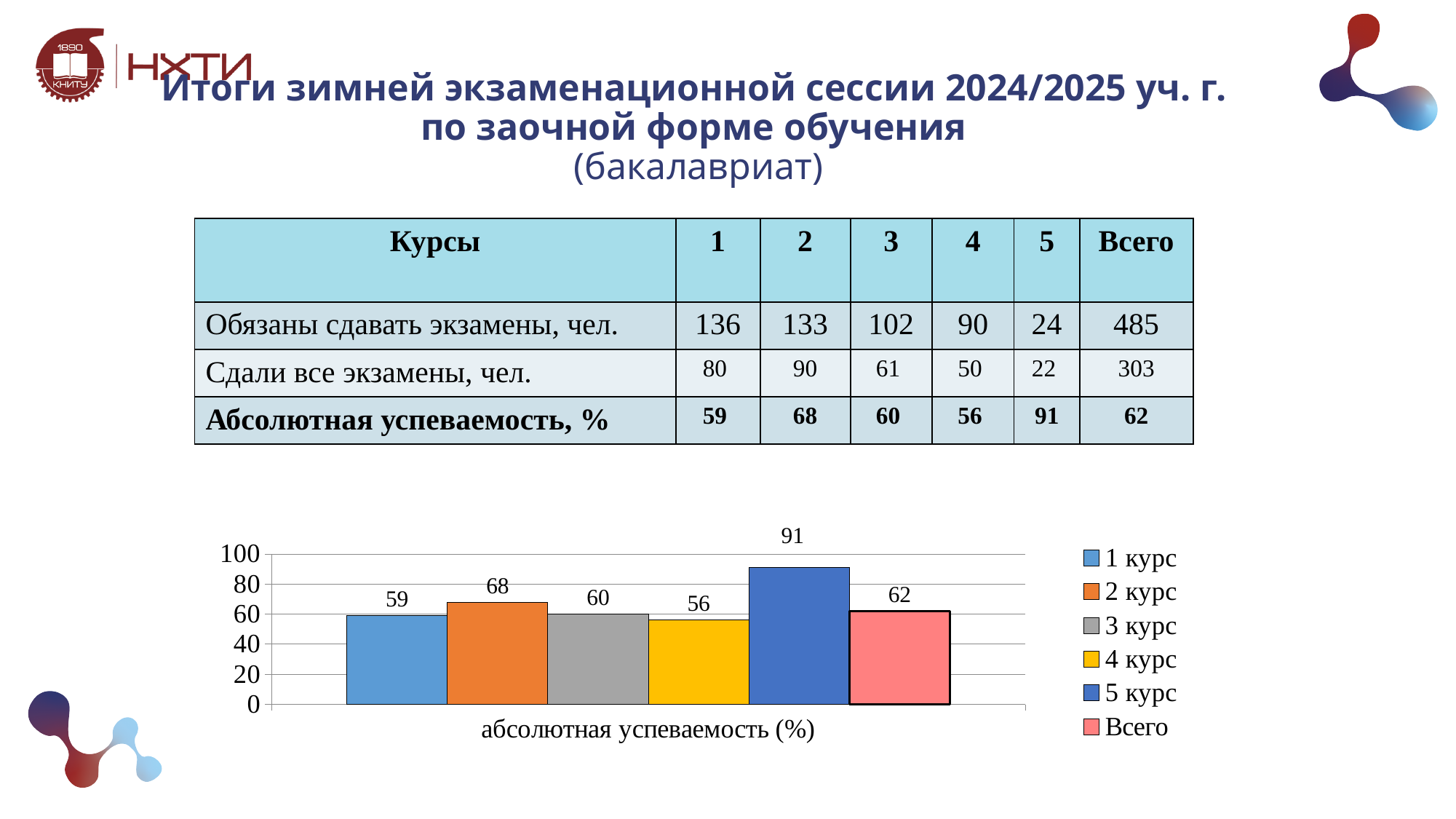
Is the value for 5 курс greater or less than 80? greater How many bars are plotted in the chart? 6 What is the x-axis label of the chart? абсолютная успеваемость (%) Which series has the lowest value in the chart? 4 курс What is the value for 5 курс in the chart? 91 What kind of chart is shown on the slide? bar chart Which series has the highest value in the chart? 5 курс What is the difference between the values for 5 курс and 4 курс? 35 How many series does the legend list? 6 What is the value for 1 курс in the chart? 59 Which is larger, the value for 2 курс or the value for 3 курс? 2 курс What is the value for Всего in the chart? 62